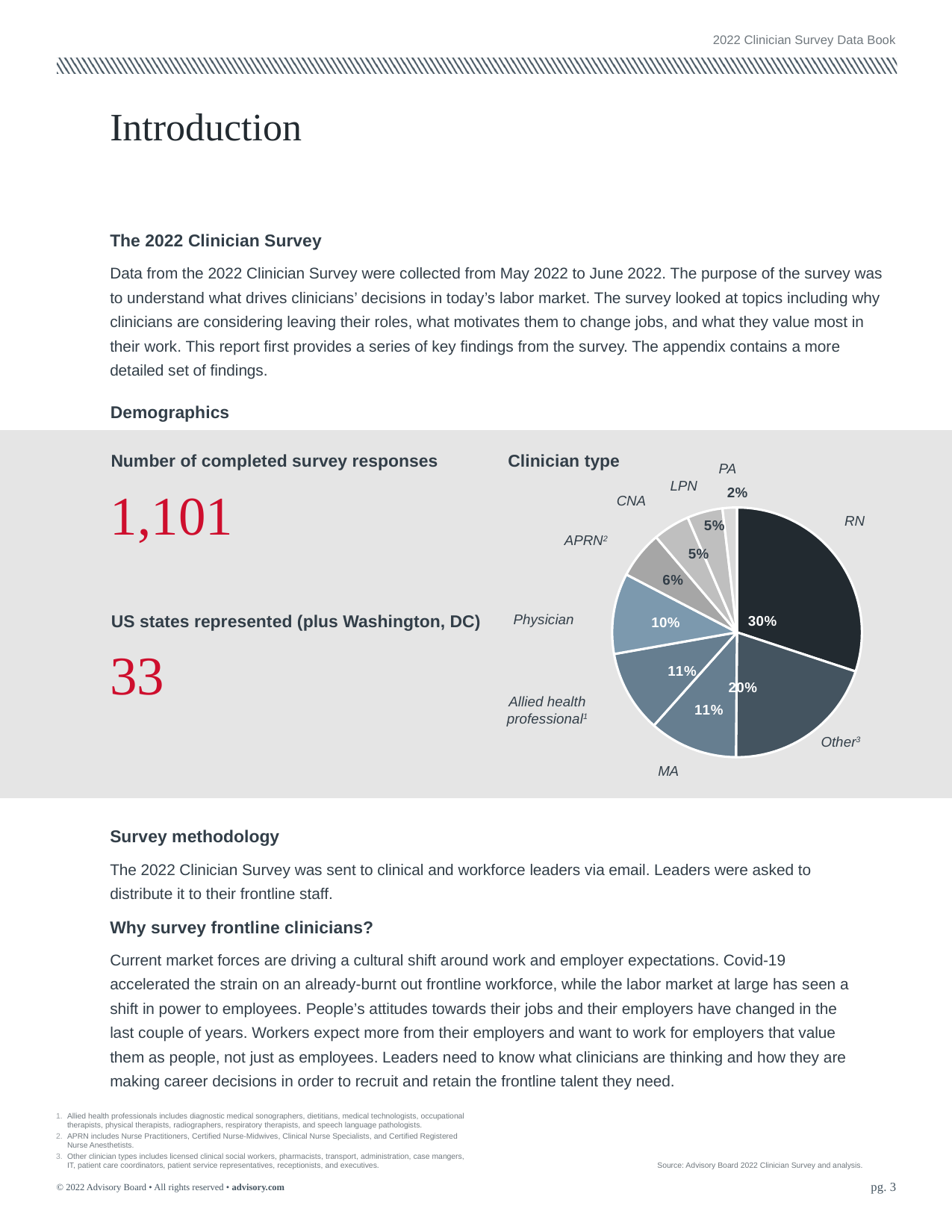
What is the title of the pie chart on the slide? Clinician type In the "Clinician type" pie chart, what percentage is labelled for Physician? 10% In the "Clinician type" pie chart, what percentage is shown for PA? 2% How many clinician type slices are shown in the "Clinician type" pie chart? 9 Which clinician type has the smallest slice in the "Clinician type" pie chart? PA Which clinician type has the largest slice in the "Clinician type" pie chart? RN In the "Clinician type" pie chart, what percentage is shown for MA? 11% In the "Clinician type" pie chart, how many percentage points larger is the RN slice than the Other slice? 10 What kind of chart is the "Clinician type" chart? pie chart In the "Clinician type" pie chart, which slice is larger: Physician or APRN? Physician In the "Clinician type" pie chart, what share of respondents are RNs? 30% In the "Clinician type" pie chart, what percentage is shown for APRN? 6%